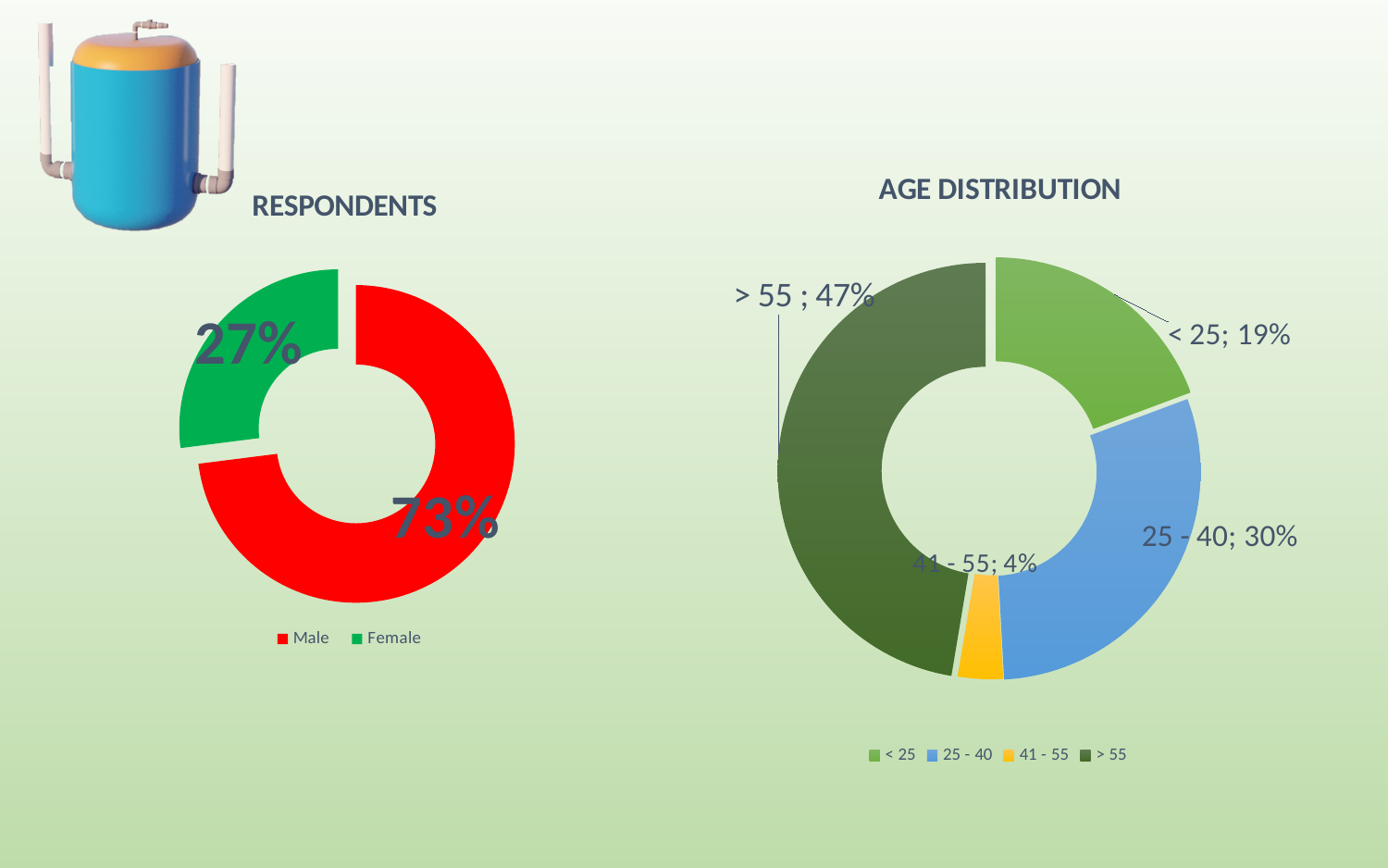
In the AGE DISTRIBUTION chart, what share is the 25 - 40 age group? 30% In the AGE DISTRIBUTION chart, what share is the > 55 age group? 47% In the AGE DISTRIBUTION chart, which age group has the smallest share? 41 - 55 In the RESPONDENTS chart, what is the difference in percentage points between Male and Female? 46 In the AGE DISTRIBUTION chart, how many age groups are shown? 4 In the RESPONDENTS chart, what percentage of respondents are Male? 73% What kind of chart is the AGE DISTRIBUTION chart? Doughnut (pie) chart In the AGE DISTRIBUTION chart, which age group has the largest share? > 55 In the RESPONDENTS chart, how many categories does the legend list? 2 In the AGE DISTRIBUTION chart, what share is the 41 - 55 age group? 4% In the RESPONDENTS chart, which category has the larger share, Male or Female? Male In the RESPONDENTS chart, what percentage of respondents are Female? 27%